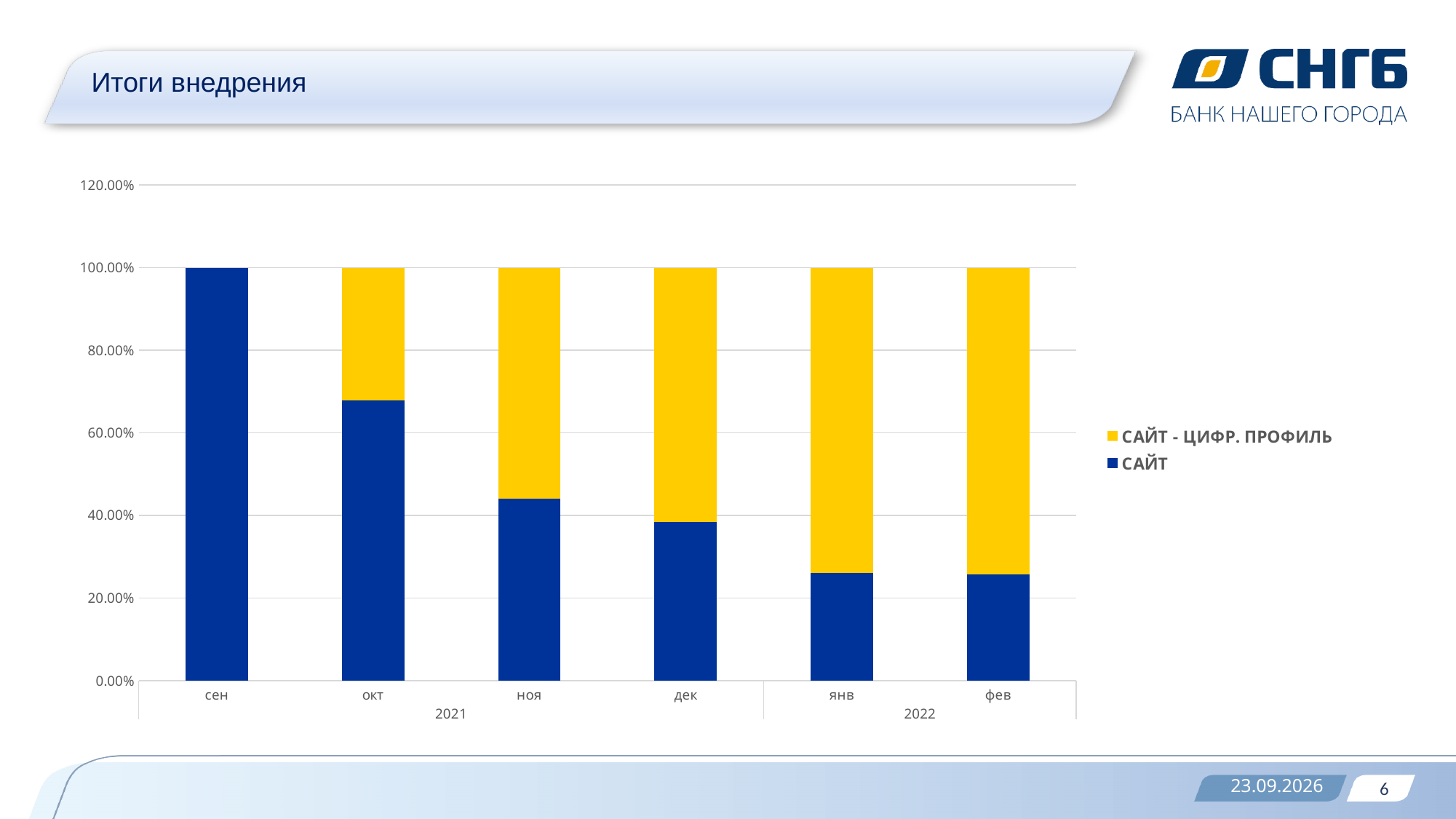
Is the value of the САЙТ series for дек greater or less than 40.00%? less How many months (categories) are shown on the x axis of the chart? 6 Which is larger: the САЙТ value for ноя or the САЙТ value for янв? ноя Which colour represents the САЙТ - ЦИФР. ПРОФИЛЬ series in the chart? Yellow Does the САЙТ series rise or fall from сен to фев? Fall Is the value of the САЙТ series for окт greater or less than 60.00%? greater What kind of chart is shown on the slide? Stacked bar chart In which month is the САЙТ series highest? сен How many series does the chart legend list? 2 What is the title of the slide containing the chart? Итоги внедрения What is the value of the САЙТ series for сен? 100.00% In which month is the САЙТ - ЦИФР. ПРОФИЛЬ series lowest? сен